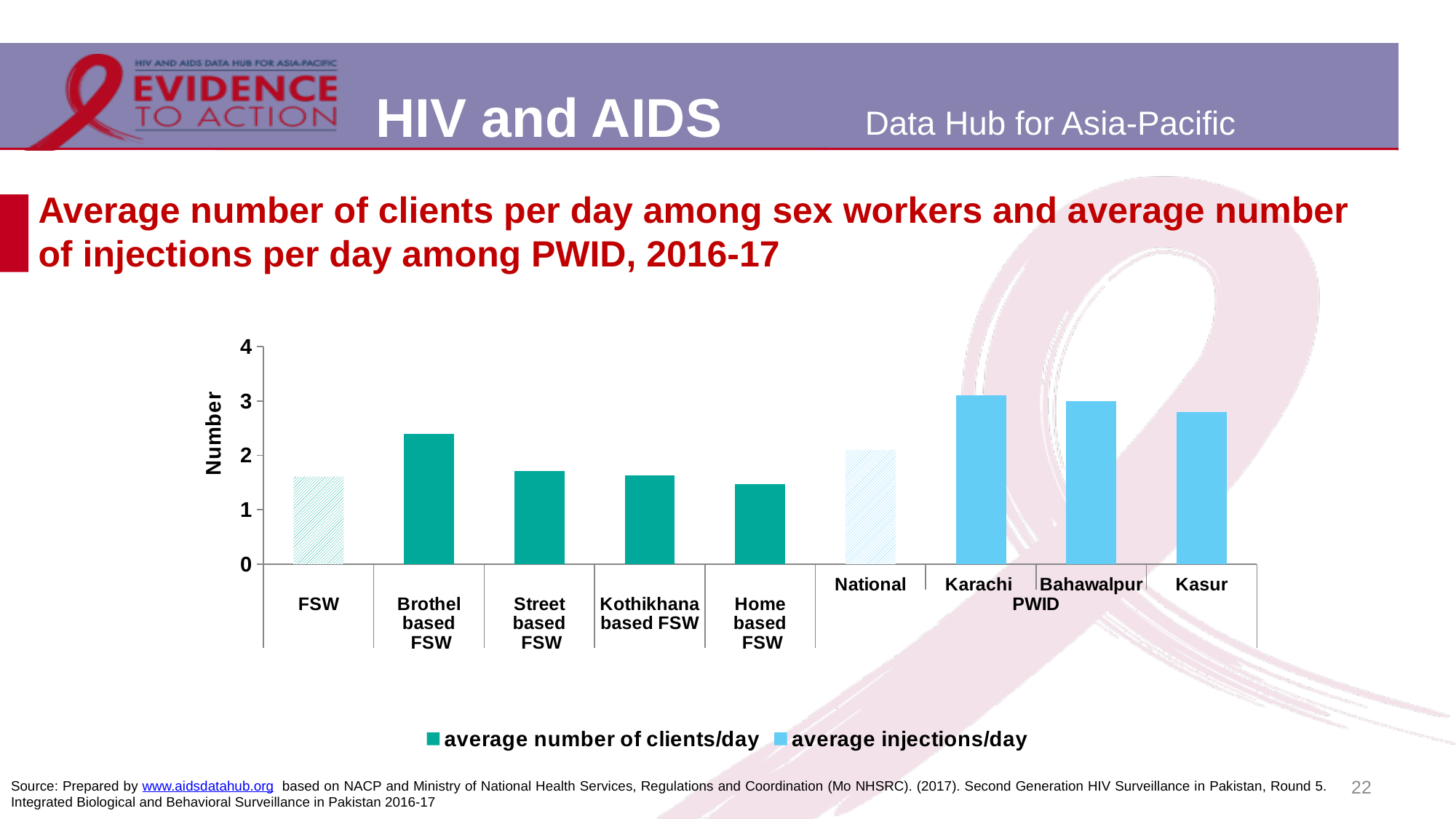
Among the FSW categories, which has the highest average number of clients per day? Brothel based FSW What is the title of the y axis? Number What kind of chart is shown on the slide? bar chart Is the value for Kasur greater or less than 3? less Which category has the lowest value in the chart? Home based FSW Is the value for Home based FSW greater or less than 2? less How many categories are plotted along the x axis? 9 How many series does the legend list? 2 Is the value for Brothel based FSW greater or less than 2? greater Which is larger, the value for Brothel based FSW or for Street based FSW? Brothel based FSW Which is larger, the value for Karachi or for Kasur? Karachi